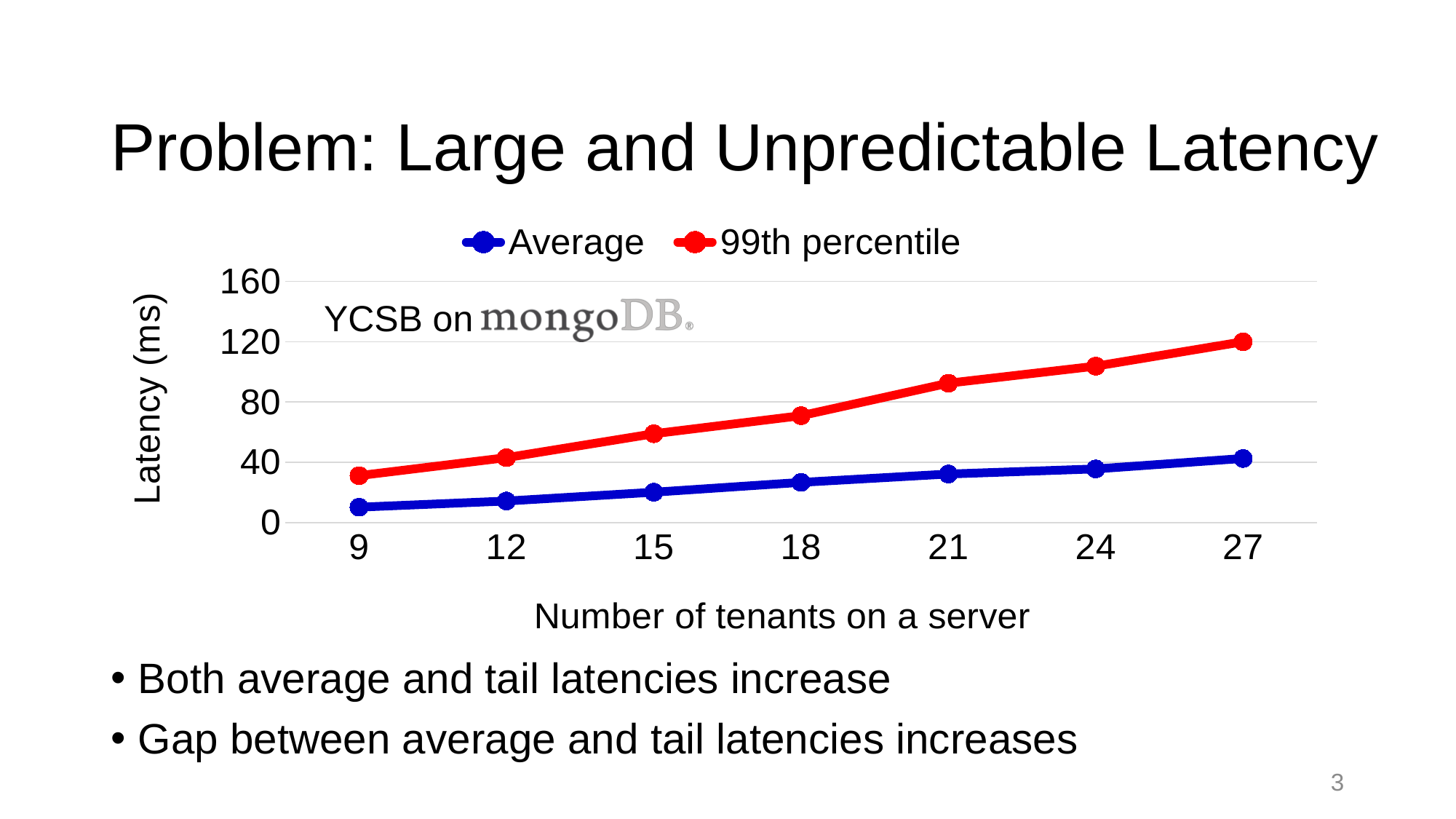
What kind of chart is shown on the slide? line chart Is the Average latency at 18 tenants greater or less than 40? less At 18 tenants, which series has the higher latency, Average or 99th percentile? 99th percentile Is the 99th percentile latency at 27 tenants greater or less than 80? greater What is the label of the y axis? Latency (ms) Do the 99th percentile latency values rise or fall as the number of tenants increases? rise At which number of tenants is the 99th percentile latency highest? 27 At which number of tenants is the Average latency lowest? 9 How many points along the x axis (numbers of tenants) are plotted for each series? 7 What is the label of the x axis? Number of tenants on a server Is the 99th percentile latency at 9 tenants greater or less than 40? less How many series does the legend list? 2